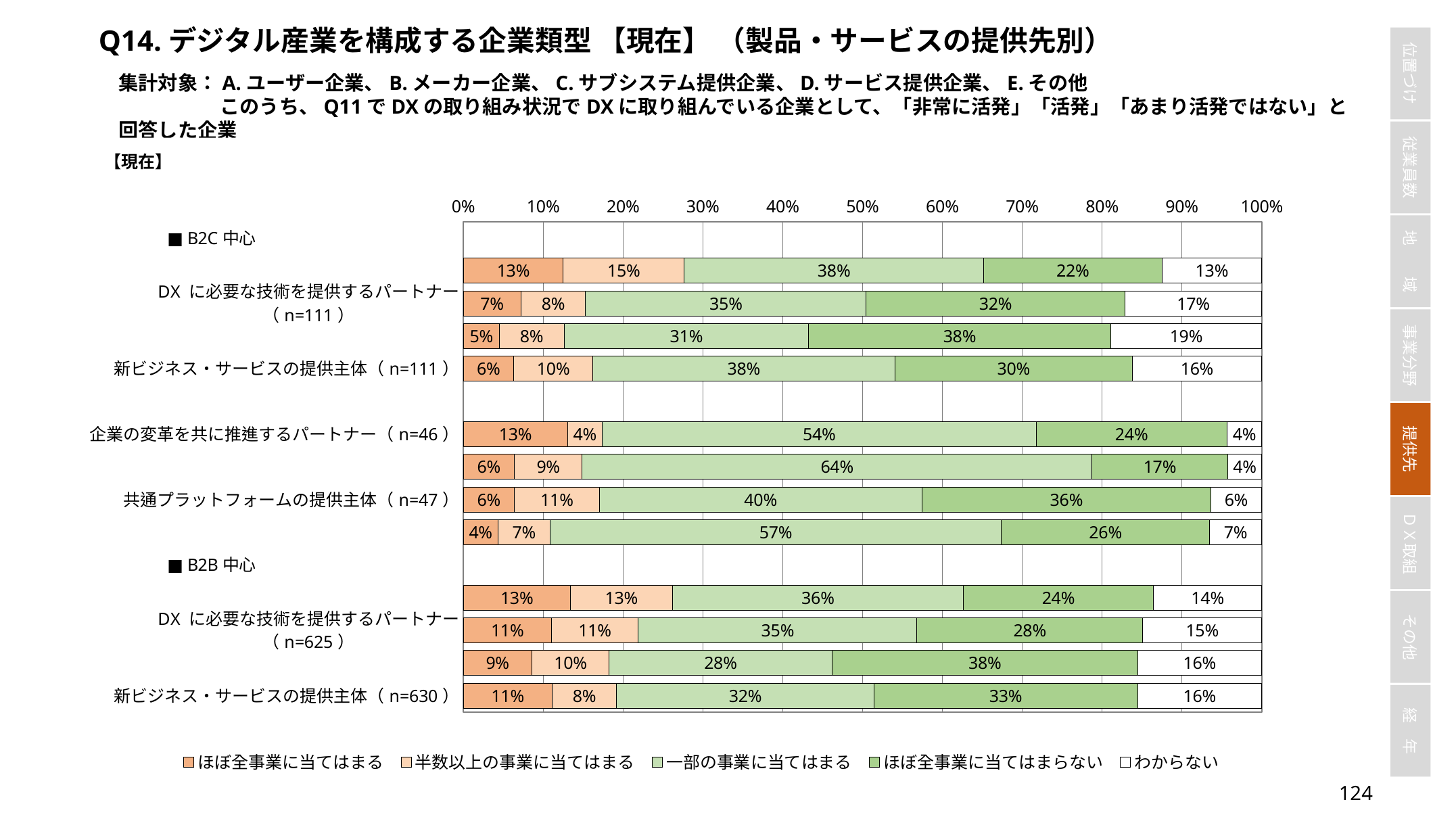
What kind of chart is shown on the slide? Stacked bar chart How many series does the legend list? 5 For 共通プラットフォームの提供主体 (n=47), what is the difference between 一部の事業に当てはまる and ほぼ全事業に当てはまらない? 4 percentage points What is the value of わからない for 新ビジネス・サービスの提供主体 (n=630) in the B2B group? 16% For 新ビジネス・サービスの提供主体 (n=630), which is larger: 一部の事業に当てはまる or ほぼ全事業に当てはまらない? ほぼ全事業に当てはまらない What is the value of わからない for 企業の変革を共に推進するパートナー (n=46)? 4% What is the value of ほぼ全事業に当てはまる for 新ビジネス・サービスの提供主体 (n=111) in the B2C group? 6% What is the value of ほぼ全事業に当てはまらない for 共通プラットフォームの提供主体 (n=47)? 36% What is the first entry in the chart legend? ほぼ全事業に当てはまる Which segment is the largest in the bar for 企業の変革を共に推進するパートナー (n=46)? 一部の事業に当てはまる How many bars are plotted in the chart? 12 What is the value of 一部の事業に当てはまる for 企業の変革を共に推進するパートナー (n=46)? 54%